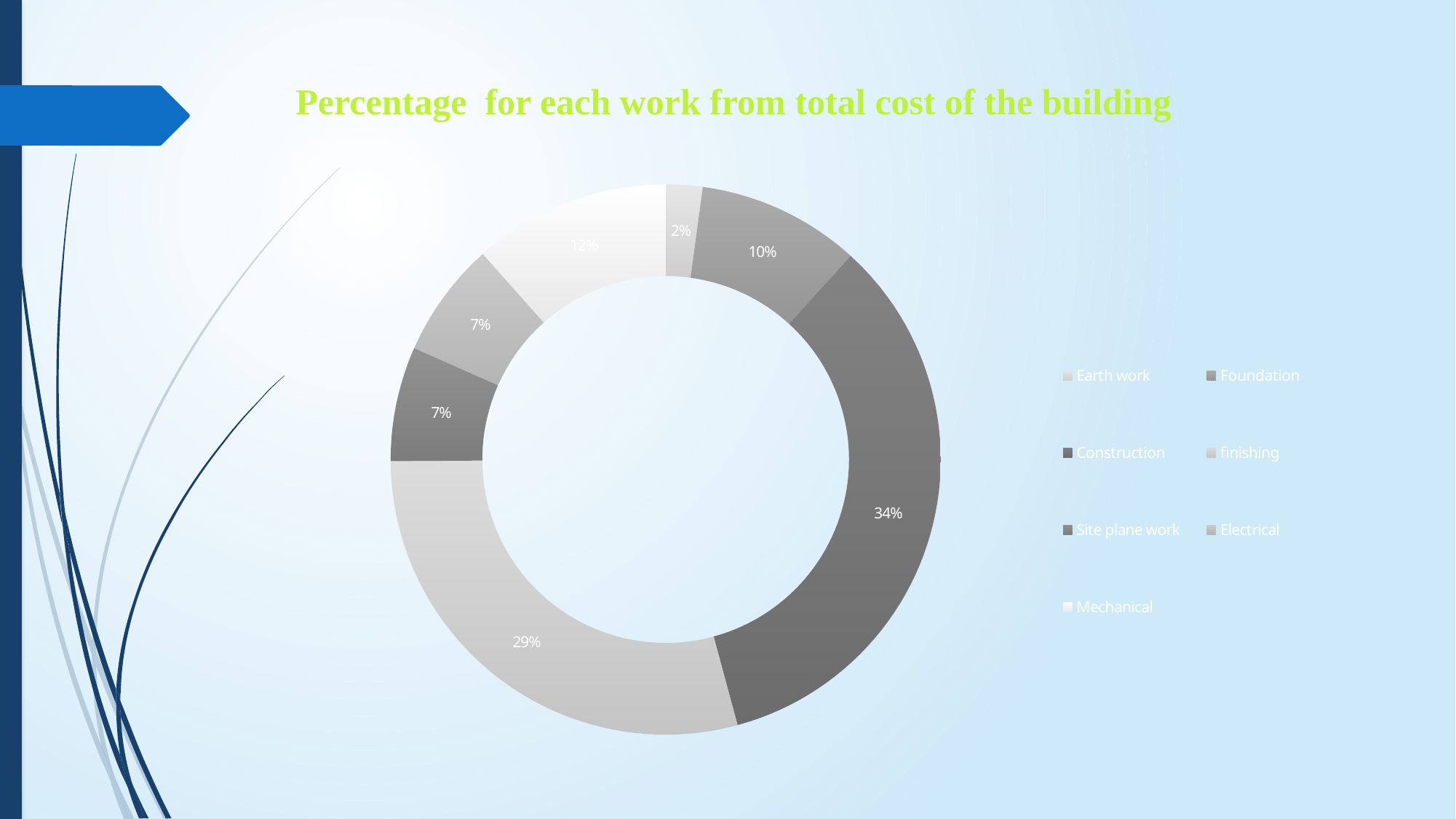
What percentage of the total cost is Foundation? 10% What is the combined share of Site plane work and Electrical? 14% What is the difference between the Construction share and the finishing share? 5% Which is larger, the share for Foundation or the share for Mechanical? Mechanical Which category has the smallest share of the total cost? Earth work What kind of chart is shown on the slide? doughnut chart What is the title of the chart? Percentage for each work from total cost of the building What percentage of the total cost is Construction? 34% How many categories does the chart show? 7 Which category has the largest share of the total cost? Construction What percentage of the total cost is finishing? 29% What percentage of the total cost is Mechanical? 12%